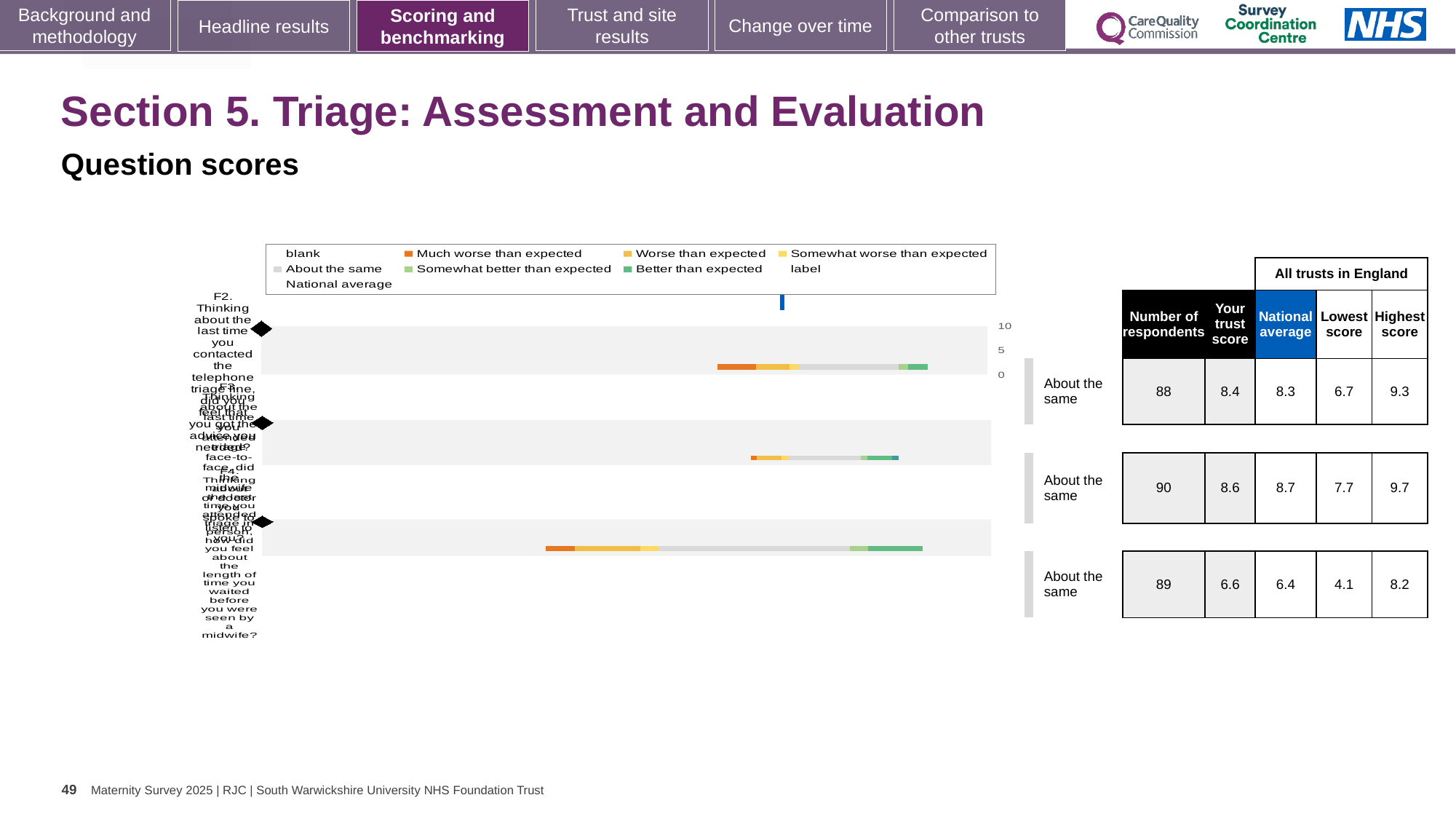
How many questions (F2, F3, F4) are plotted in the chart? 3 Which question has the lowest 'Your trust score'? F4 For question F2, which is larger: the 'Your trust score' or the national average? Your trust score What kind of chart is shown on the slide? bar chart What is the 'Your trust score' for question F2 (first row)? 8.4 How many entries does the chart legend list? 9 How many respondents answered question F3 (second row)? 90 What is the lowest score across all trusts in England for question F4 (third row)? 4.1 What is the national average for question F3 (second row)? 8.7 Which question has the highest 'Your trust score'? F3 What colour does the legend use for 'Much worse than expected'? orange What is the difference between the 'Your trust score' for F3 and for F4? 2.0